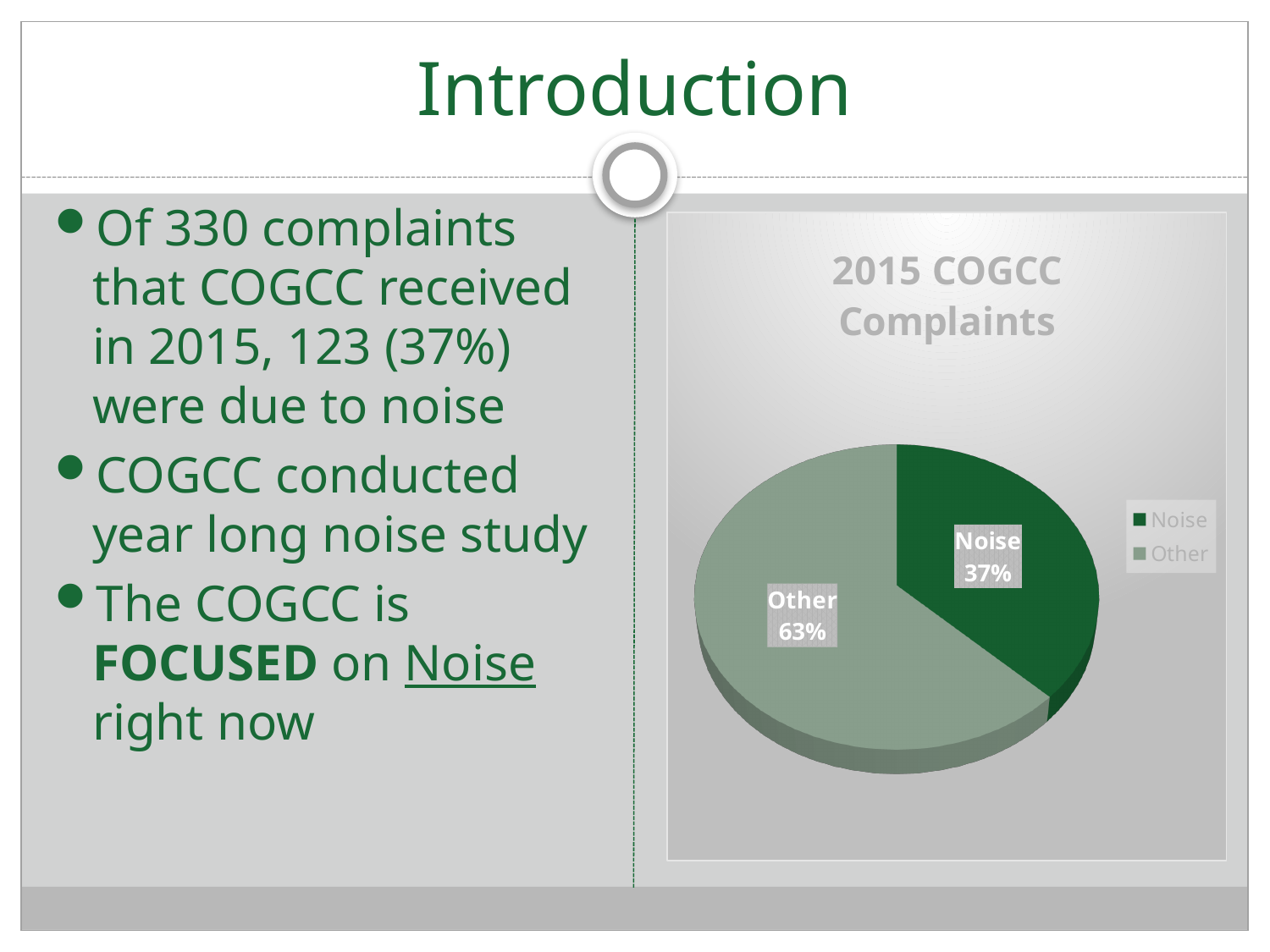
What type of chart is shown on the slide? pie chart Which slice of the pie is the largest? Other Which legend entry is shown in dark green? Noise What is the title of the chart? 2015 COGCC Complaints What share of the pie does the Noise slice represent? 37% Which is larger, the Noise slice or the Other slice? Other How many entries does the legend list? 2 Which slice of the pie is the smallest? Noise How many slices does the pie chart have? 2 What is the difference in percentage points between the Other slice and the Noise slice? 26% What share of the pie does the Other slice represent? 63%